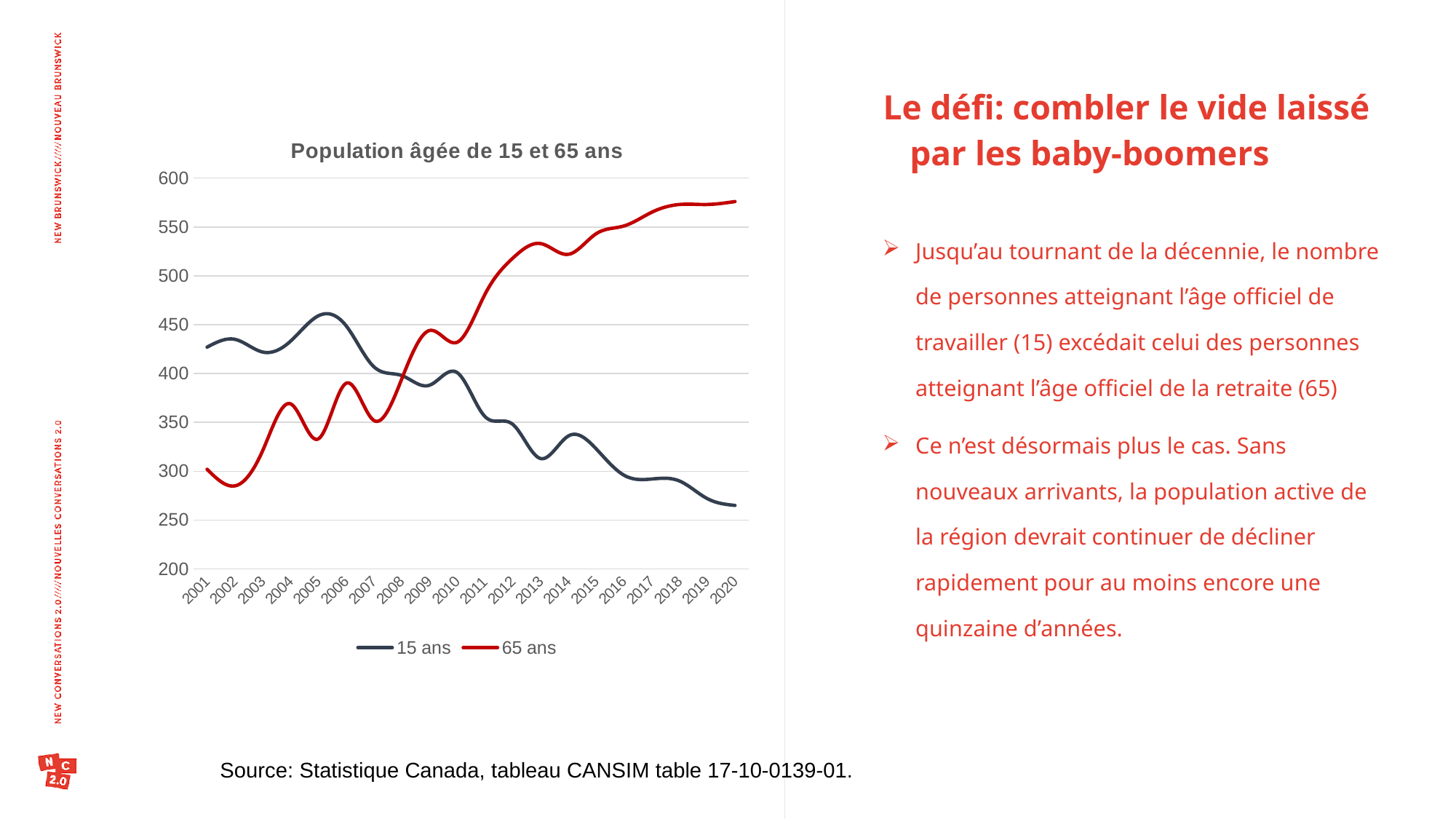
How many series does the chart legend list? 2 What colour is the line for the '65 ans' series? red How many years are shown on the x axis of the chart? 20 In 2020, which series has the higher value, '15 ans' or '65 ans'? 65 ans Does the '65 ans' series rise or fall overall from 2001 to 2020? rise What is the title of the chart? Population âgée de 15 et 65 ans Does the '15 ans' series rise or fall overall from 2001 to 2020? fall What kind of chart is shown on the slide? line chart Is the value for '65 ans' in 2020 greater or less than 550? greater In 2001, which series has the higher value, '15 ans' or '65 ans'? 15 ans Is the value for '65 ans' in 2001 greater or less than 350? less Is the value for '15 ans' in 2020 greater or less than 300? less